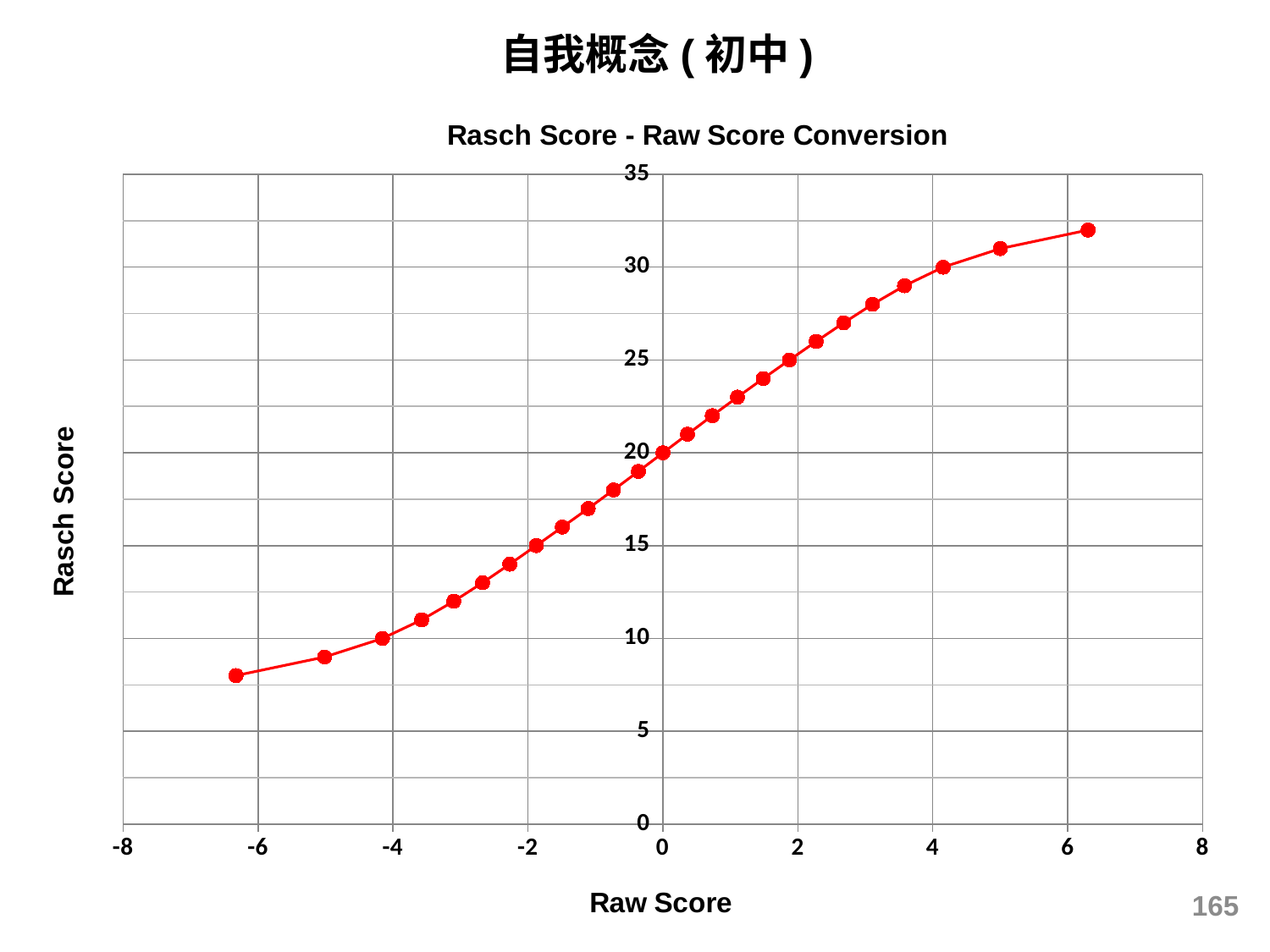
Is the highest plotted Rasch Score greater or less than 30? greater What is the title of the chart? Rasch Score - Raw Score Conversion What is the maximum value shown on the vertical axis? 35 How many data points are plotted on the chart? 25 Which has the larger Rasch Score: the point at Raw Score 4 or the point at Raw Score -4? the point at Raw Score 4 What is the Rasch Score of the point plotted at Raw Score 0? 20 Is the lowest plotted Rasch Score greater or less than 10? less Do the plotted values rise or fall as Raw Score increases along the x axis? rise What kind of chart is shown on the slide? line chart What is the label of the vertical axis? Rasch Score